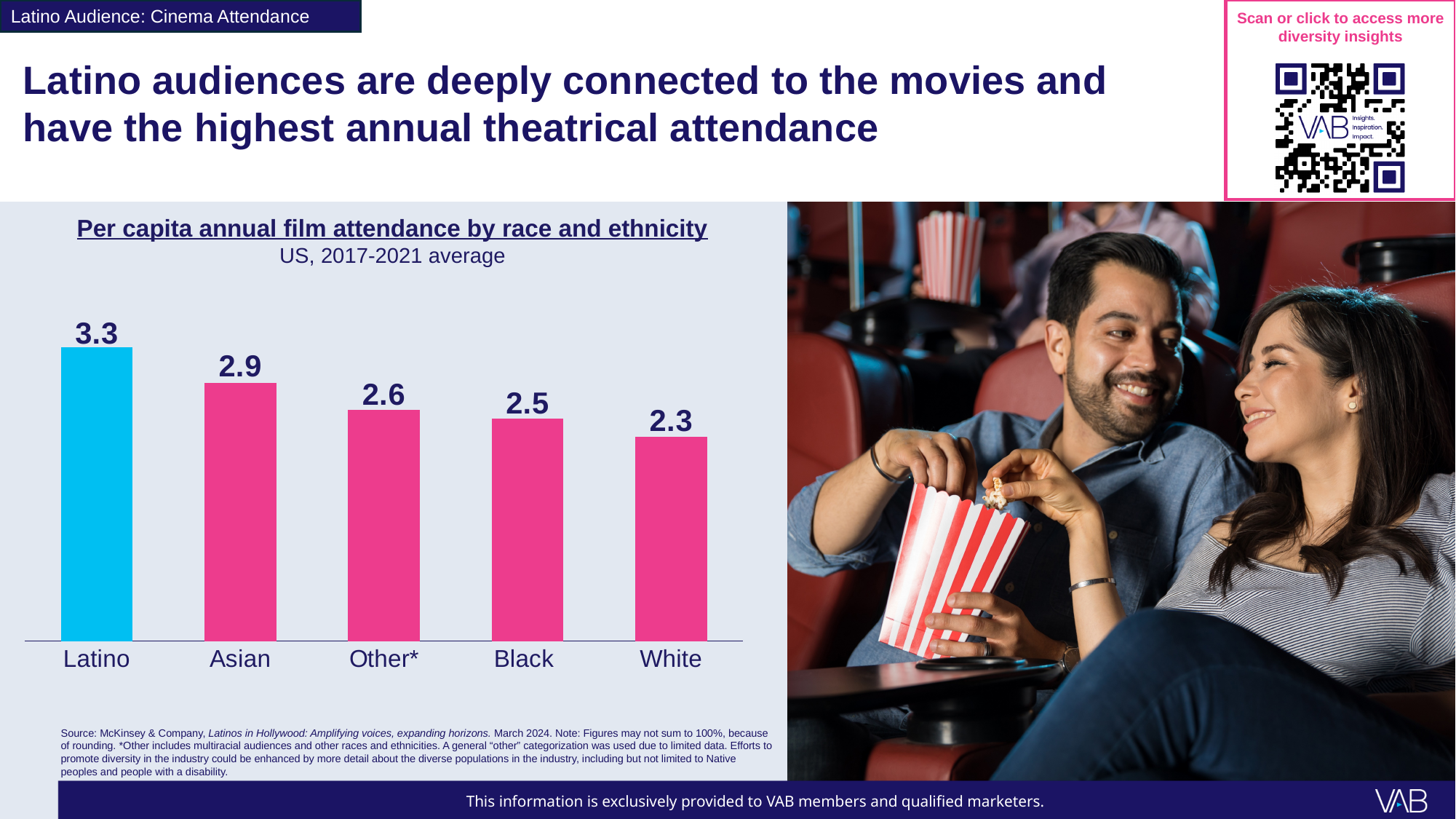
Which has a higher per capita annual film attendance, Other* or Black? Other* Which bar is coloured differently (blue) from the others in the chart? Latino What is the per capita annual film attendance for Asian audiences? 2.9 What is the per capita annual film attendance for Latino audiences? 3.3 What is the per capita annual film attendance for White audiences? 2.3 Which group has the highest per capita annual film attendance? Latino Which group has the lowest per capita annual film attendance? White Do the values rise or fall moving from Latino to White along the x axis? Fall What is the difference in per capita annual film attendance between Latino and White audiences? 1.0 What is the difference in per capita annual film attendance between Asian and Black audiences? 0.4 What kind of chart is used to show per capita annual film attendance? Bar chart How many race and ethnicity groups are shown in the chart? 5